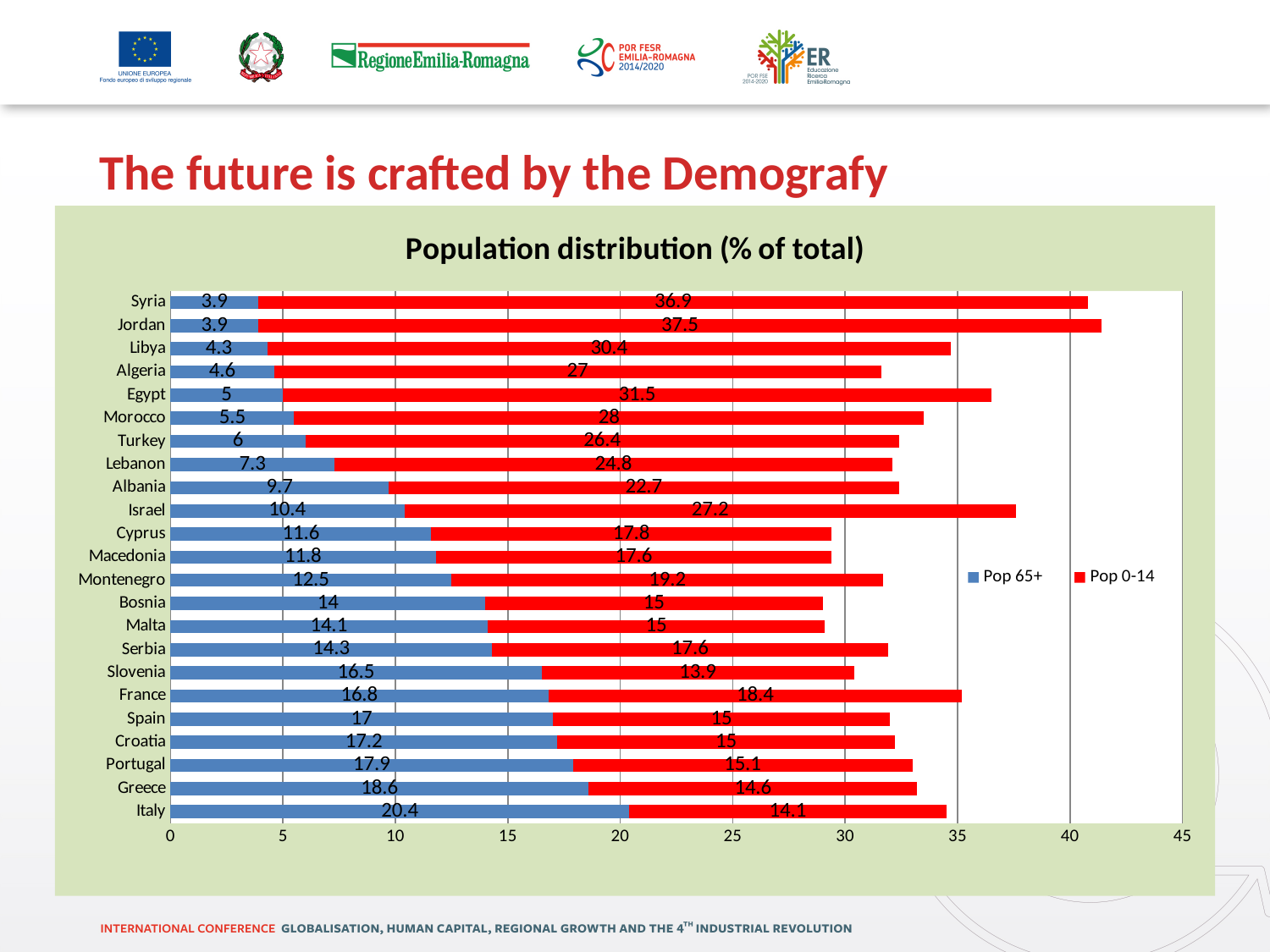
What is the Pop 65+ value for Italy? 20.4 What is the Pop 0-14 value for Egypt? 31.5 Which country has the highest Pop 0-14 value? Jordan What is the total of the stacked bar for Italy? 34.5 Which is larger for Greece, the Pop 65+ value or the Pop 0-14 value? Pop 65+ Which country has the highest Pop 65+ value? Italy How many countries are shown in the chart? 23 Which country has the lowest Pop 0-14 value? Slovenia How many series does the legend list? 2 What type of chart is shown on the slide? Stacked bar chart What is the Pop 65+ value for Montenegro? 12.5 What is the difference between the Pop 0-14 and Pop 65+ values for Jordan? 33.6